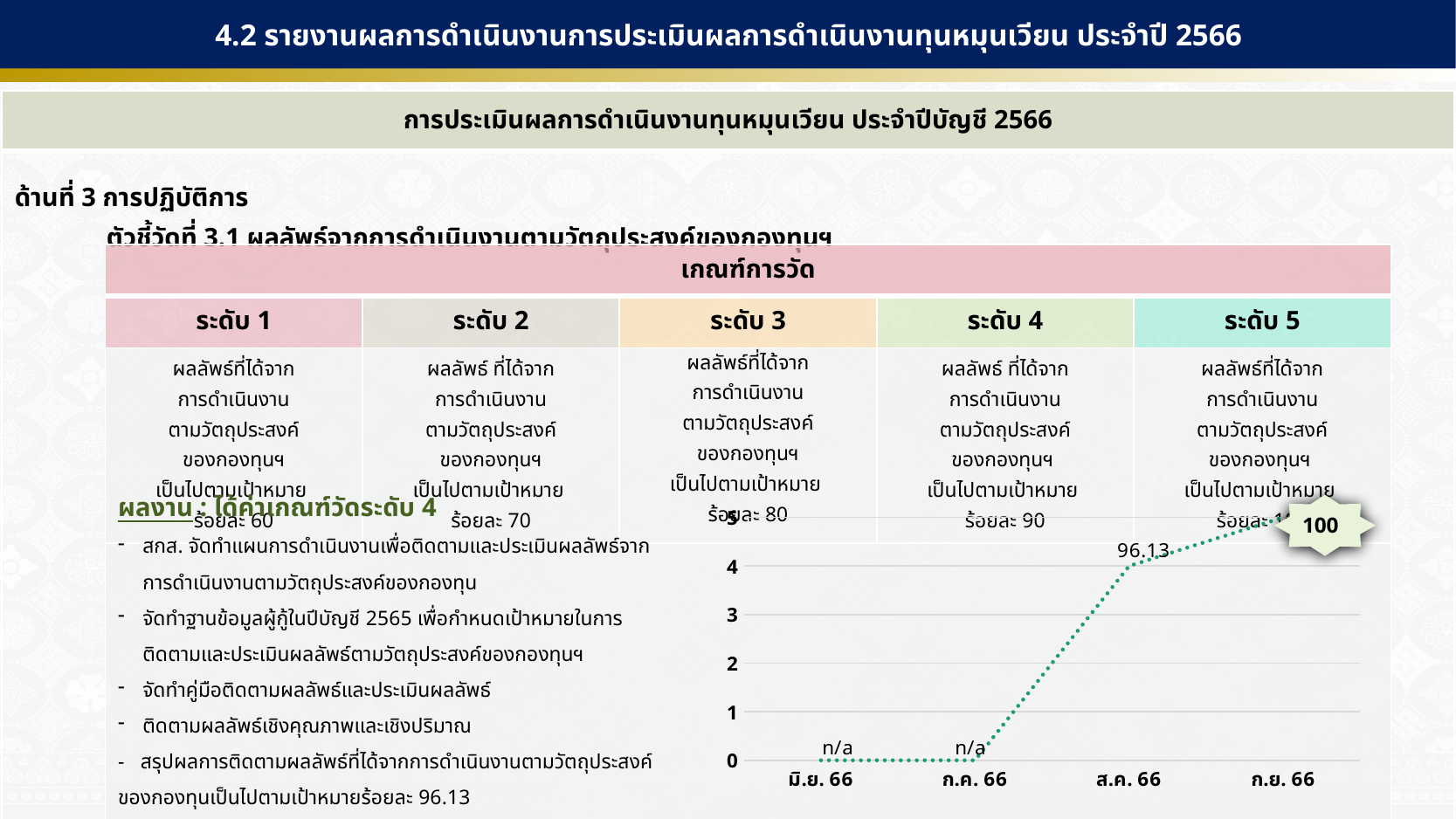
Is the point for ก.ย. 66 greater or less than 4 on the y axis? greater What kind of chart is shown on the slide? line chart What data label is shown for ก.ค. 66 on the chart? n/a Which category has the highest point on the chart? ก.ย. 66 Do the values on the chart rise or fall from left to right along the x axis? rise Is the point for ส.ค. 66 greater or less than 3 on the y axis? greater How many categories are shown on the x axis of the chart? 4 What data label is shown for มิ.ย. 66 on the chart? n/a What data label is shown for ส.ค. 66 on the chart? 96.13 What is the highest tick value shown on the y axis of the chart? 5 What is the first category label on the x axis of the chart? มิ.ย. 66 Which is higher on the chart, the point for ส.ค. 66 or the point for ก.ค. 66? ส.ค. 66